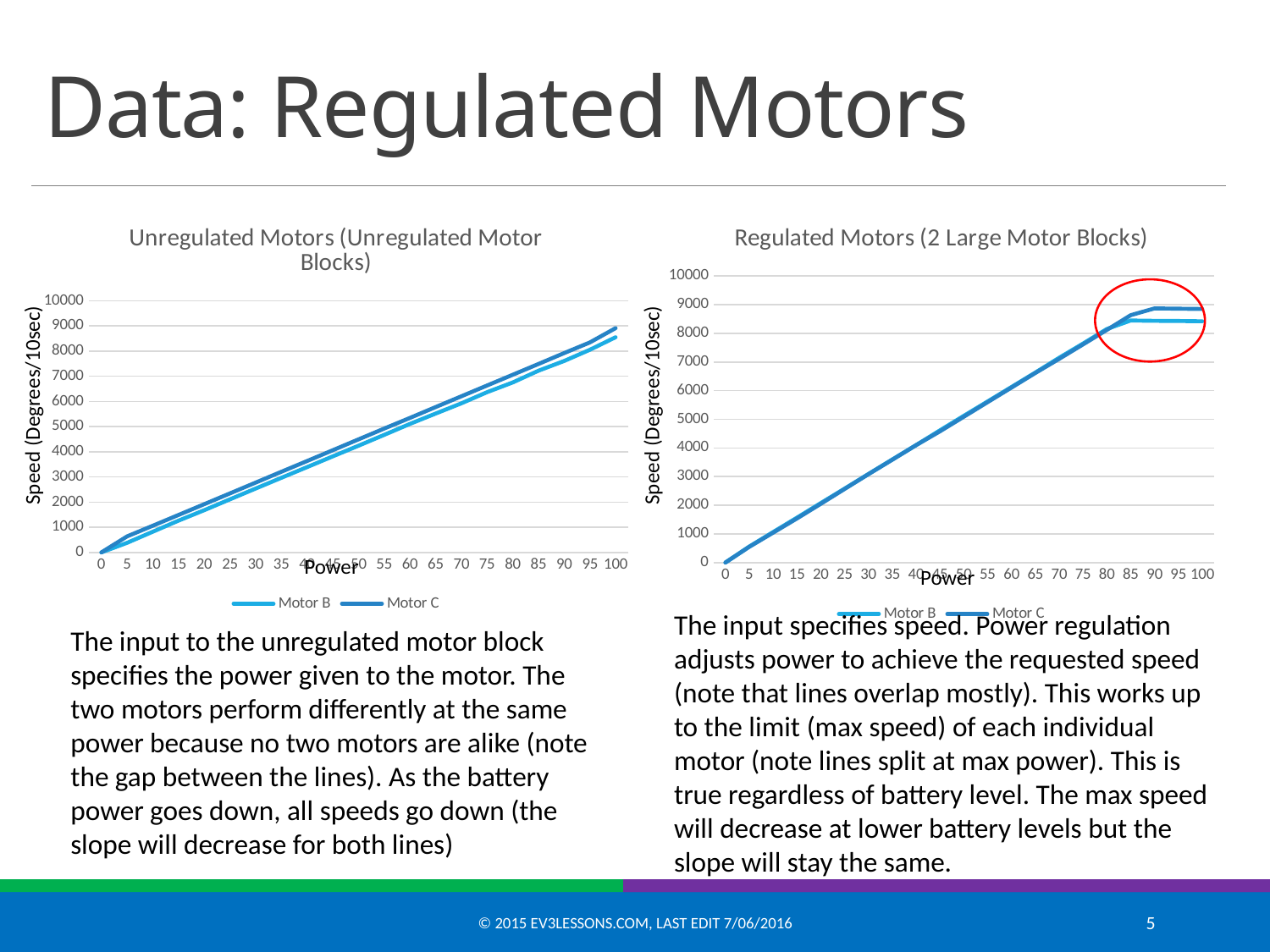
How many series does the legend of the 'Regulated Motors (2 Large Motor Blocks)' chart list? 2 In the 'Unregulated Motors (Unregulated Motor Blocks)' chart, is the value for Motor C at power 50 greater or less than 4000? greater In the 'Unregulated Motors (Unregulated Motor Blocks)' chart, do the speed values rise or fall as power increases from 0 to 100? rise What kind of chart is the 'Unregulated Motors (Unregulated Motor Blocks)' chart? line chart In the 'Regulated Motors (2 Large Motor Blocks)' chart, is the value for Motor B at power 100 greater or less than 9000? less In the 'Unregulated Motors (Unregulated Motor Blocks)' chart, is the value for Motor C at power 100 greater or less than 8000? greater How many power values are labelled on the x axis of the 'Regulated Motors (2 Large Motor Blocks)' chart? 21 In the 'Regulated Motors (2 Large Motor Blocks)' chart, which series has the higher speed at power 100, Motor B or Motor C? Motor C What is the y-axis label of the 'Regulated Motors (2 Large Motor Blocks)' chart? Speed (Degrees/10sec) In the 'Unregulated Motors (Unregulated Motor Blocks)' chart, which series has the higher speed at power 100, Motor B or Motor C? Motor C In the 'Unregulated Motors (Unregulated Motor Blocks)' chart, what are the two series named in the legend? Motor B and Motor C